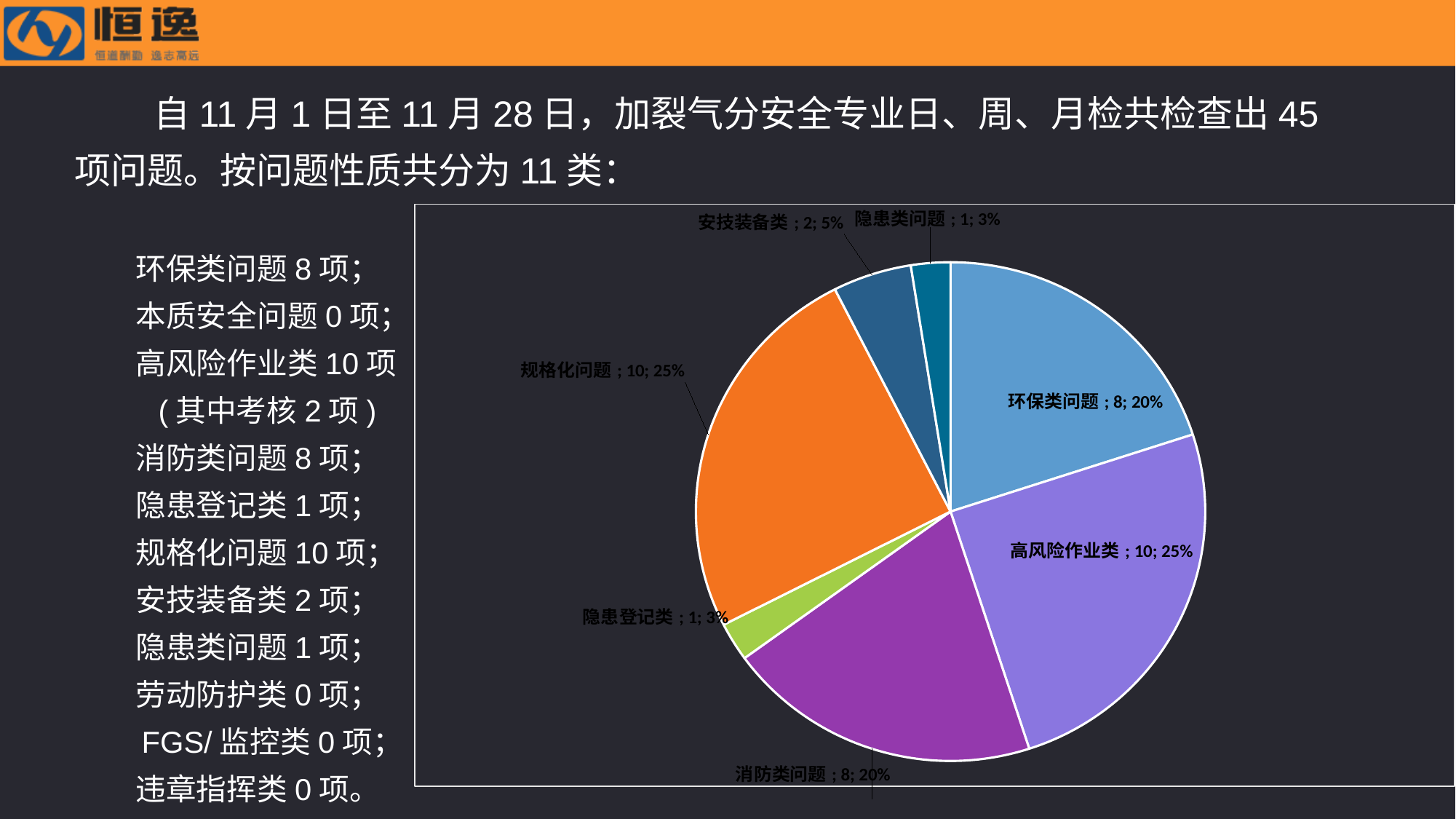
Which is larger, the value for 环保类问题 or the value for 隐患登记类? 环保类问题 What is the difference between the values for 消防类问题 and 隐患类问题? 7 What is the value for 环保类问题 in the pie chart? 8 What kind of chart is shown on the slide? pie chart Which slice has the smallest share, 安技装备类 or 隐患登记类? 隐患登记类 What share of the pie does 消防类问题 represent? 20% What share of the pie does 高风险作业类 represent? 25% What share of the pie does 隐患类问题 represent? 3% How many slices does the pie chart have? 7 What is the difference between the values for 高风险作业类 and 安技装备类? 8 What is the value for 规格化问题 in the pie chart? 10 What is the value for 安技装备类 in the pie chart? 2